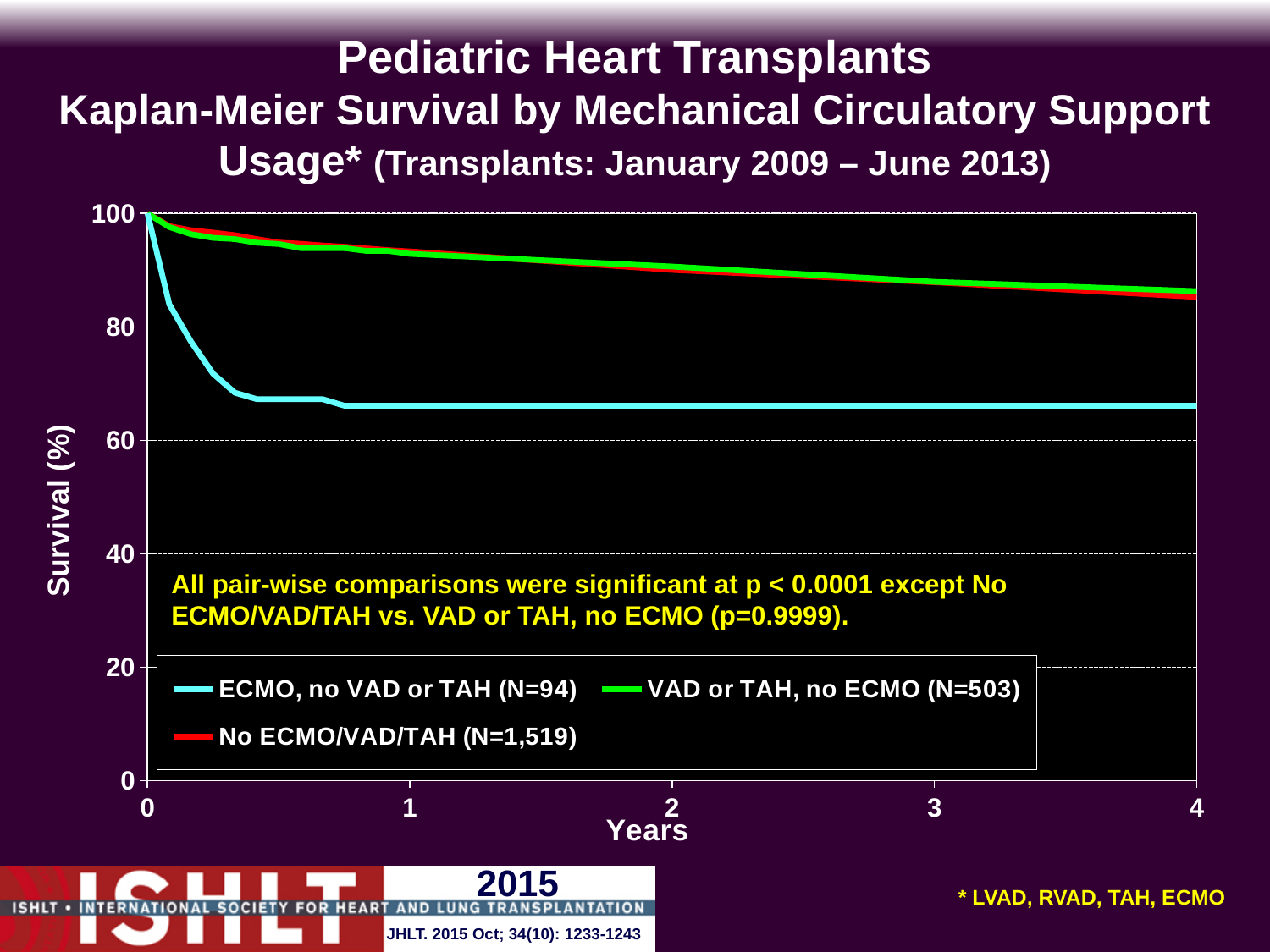
Is the survival for ECMO, no VAD or TAH at 4 years greater or less than 60? greater Is the survival for No ECMO/VAD/TAH at 2 years greater or less than 80? greater Is the survival for ECMO, no VAD or TAH at 4 years greater or less than 80? less What kind of chart is shown on the slide? Line chart How many series does the legend list? 3 Does survival for ECMO, no VAD or TAH rise or fall over the first year? Fall Which series has the lowest survival at 4 years? ECMO, no VAD or TAH (N=94) What is the N for the No ECMO/VAD/TAH series in the legend? N=1,519 At 2 years, which has higher survival: ECMO, no VAD or TAH, or VAD or TAH, no ECMO? VAD or TAH, no ECMO What is the label of the y axis? Survival (%) What is the maximum value shown on the x axis? 4